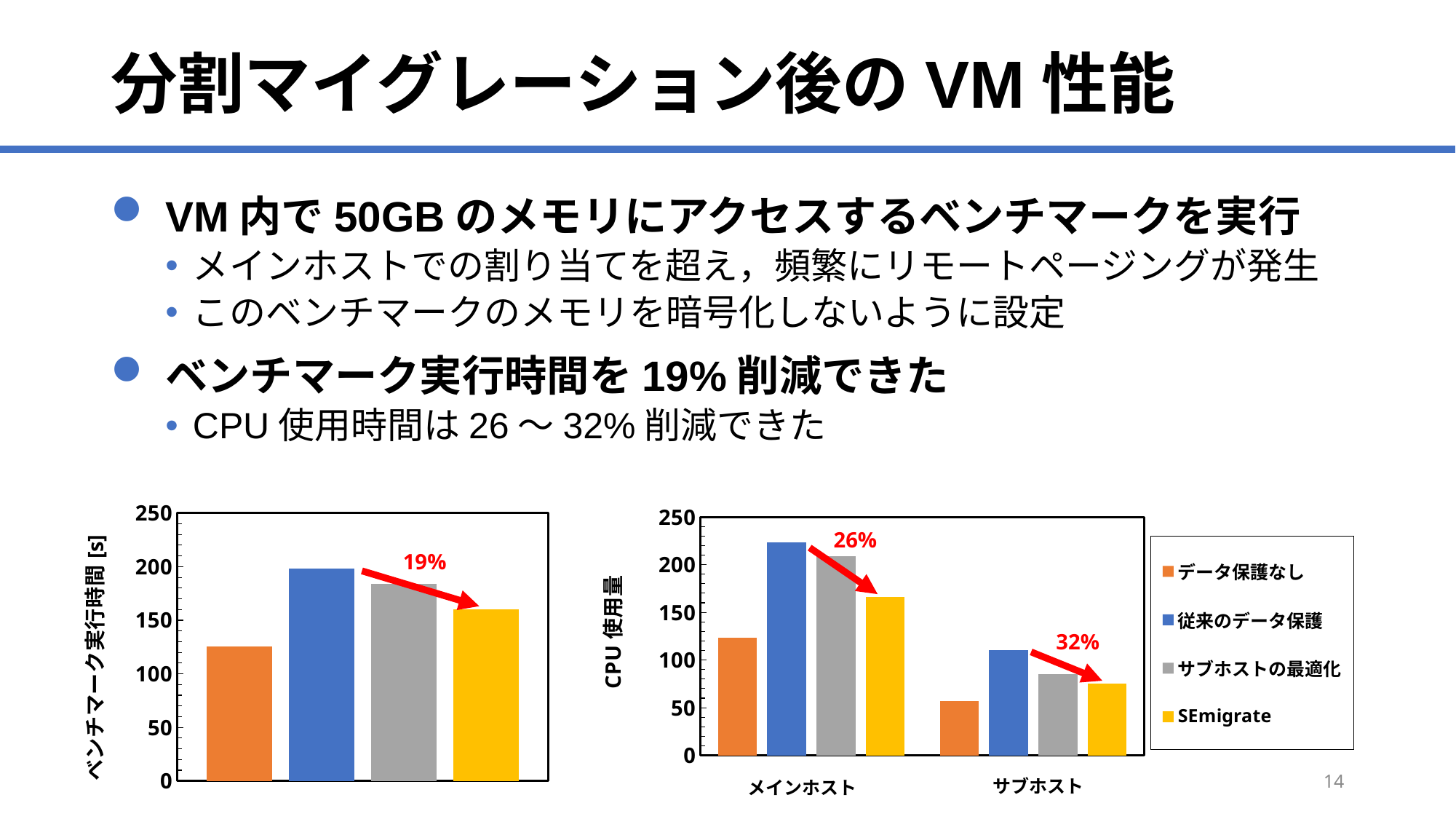
In the left chart (ベンチマーク実行時間 [s]), is the value for データ保護なし greater or less than 150? less In the right chart (CPU 使用量), is the value for 従来のデータ保護 at メインホスト greater or less than 200? greater In the left chart (ベンチマーク実行時間 [s]), is the value for 従来のデータ保護 greater or less than 150? greater What kind of chart is the left chart (ベンチマーク実行時間 [s])? bar chart In the right chart (CPU 使用量), how many categories are shown on the x axis? 2 In the right chart (CPU 使用量), what percentage reduction is annotated above the サブホスト bars? 32% In the left chart (ベンチマーク実行時間 [s]), which series has the highest value? 従来のデータ保護 In the right chart (CPU 使用量), which category has the larger value for 従来のデータ保護, メインホスト or サブホスト? メインホスト How many series does the legend list? 4 In the left chart (ベンチマーク実行時間 [s]), which series has the lowest value? データ保護なし